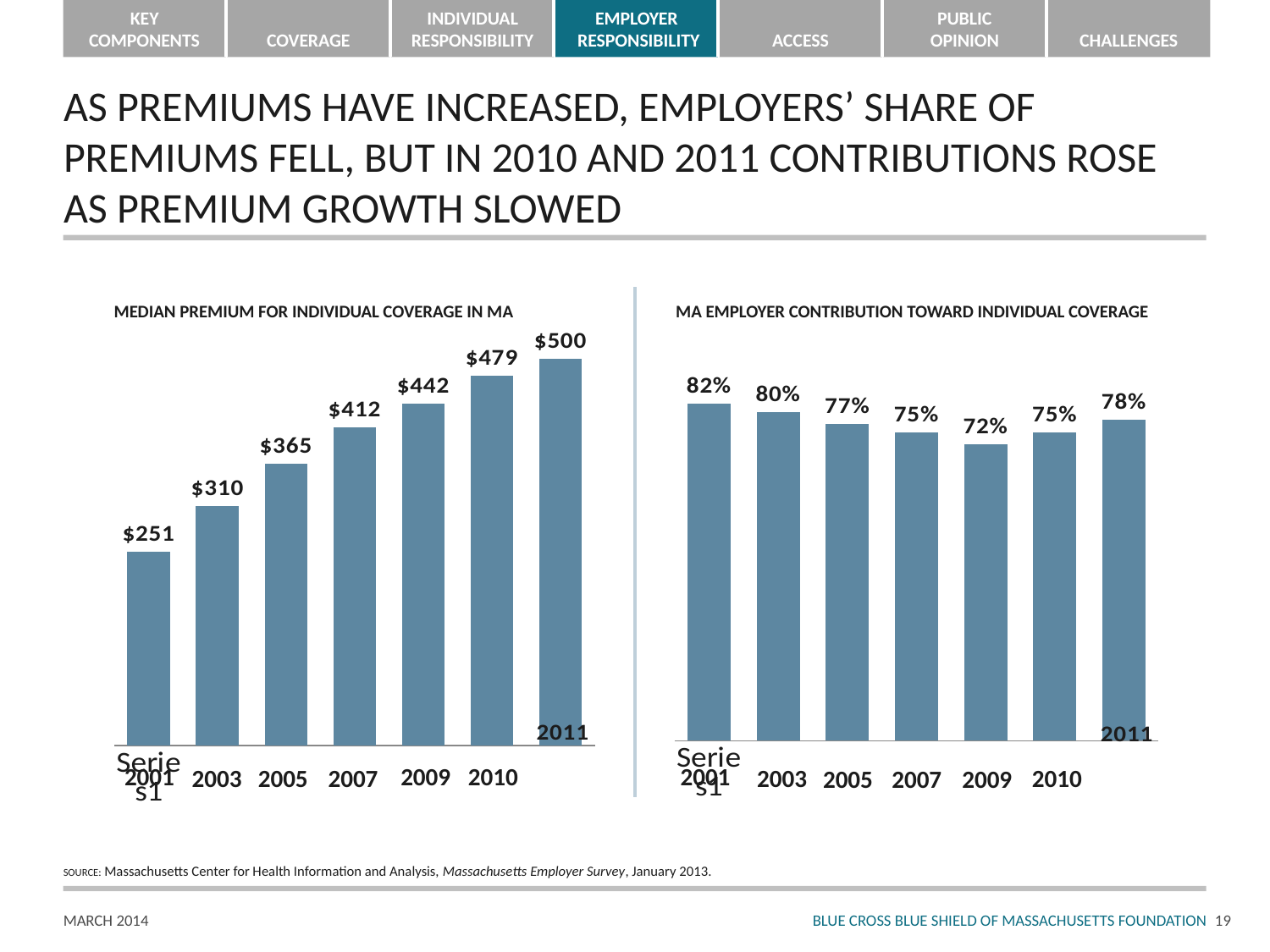
What type of chart is the 'MA Employer Contribution Toward Individual Coverage' chart? bar chart In the 'MA Employer Contribution Toward Individual Coverage' chart, what is the value for 2011? 78% In the 'MA Employer Contribution Toward Individual Coverage' chart, which year has the highest value? 2001 In the 'MA Employer Contribution Toward Individual Coverage' chart, what is the value for 2009? 72% In the 'Median Premium for Individual Coverage in MA' chart, which year has the lowest value? 2001 In the 'MA Employer Contribution Toward Individual Coverage' chart, what is the difference between the 2001 and 2009 values? 10% In the 'Median Premium for Individual Coverage in MA' chart, what is the value for 2005? $365 How many years are shown in the 'Median Premium for Individual Coverage in MA' chart? 7 In the 'Median Premium for Individual Coverage in MA' chart, what is the difference between the 2011 and 2001 values? $249 In the 'MA Employer Contribution Toward Individual Coverage' chart, which year has the lowest value? 2009 In the 'Median Premium for Individual Coverage in MA' chart, do the values rise or fall from 2001 to 2011? rise In the 'Median Premium for Individual Coverage in MA' chart, what is the value for 2011? $500